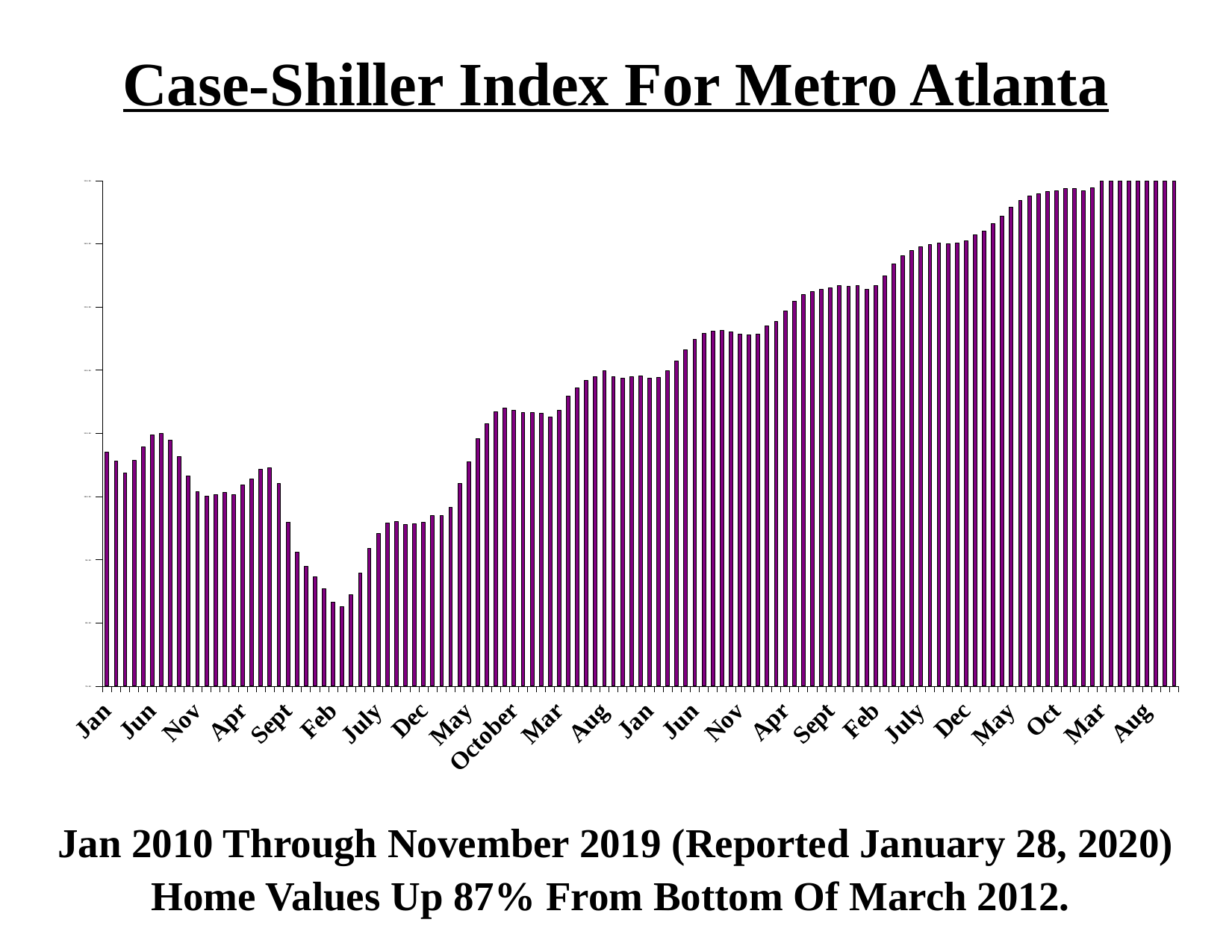
What is the title of the chart? Case-Shiller Index For Metro Atlanta According to the slide, by what percentage are home values up from the bottom of March 2012? 87% Which bar is taller: the one at the first 'Nov' label or the one at the second 'Nov' label? the second 'Nov' label From the first 'Sept' label to the first 'Feb' label, do the bars rise or fall? fall According to the slide, in which month did the index reach its bottom? March 2012 Which bar is taller: the one at the first 'Jun' label or the one at the first 'Feb' label? the first 'Jun' label What kind of chart is shown on the slide? bar chart Which bar is taller: the one at the first 'Jan' label or the one at the last 'Aug' label? the last 'Aug' label Overall, do the bars rise or fall from the left end of the chart to the right end? rise Are the tallest bars at the left end or the right end of the chart? right end